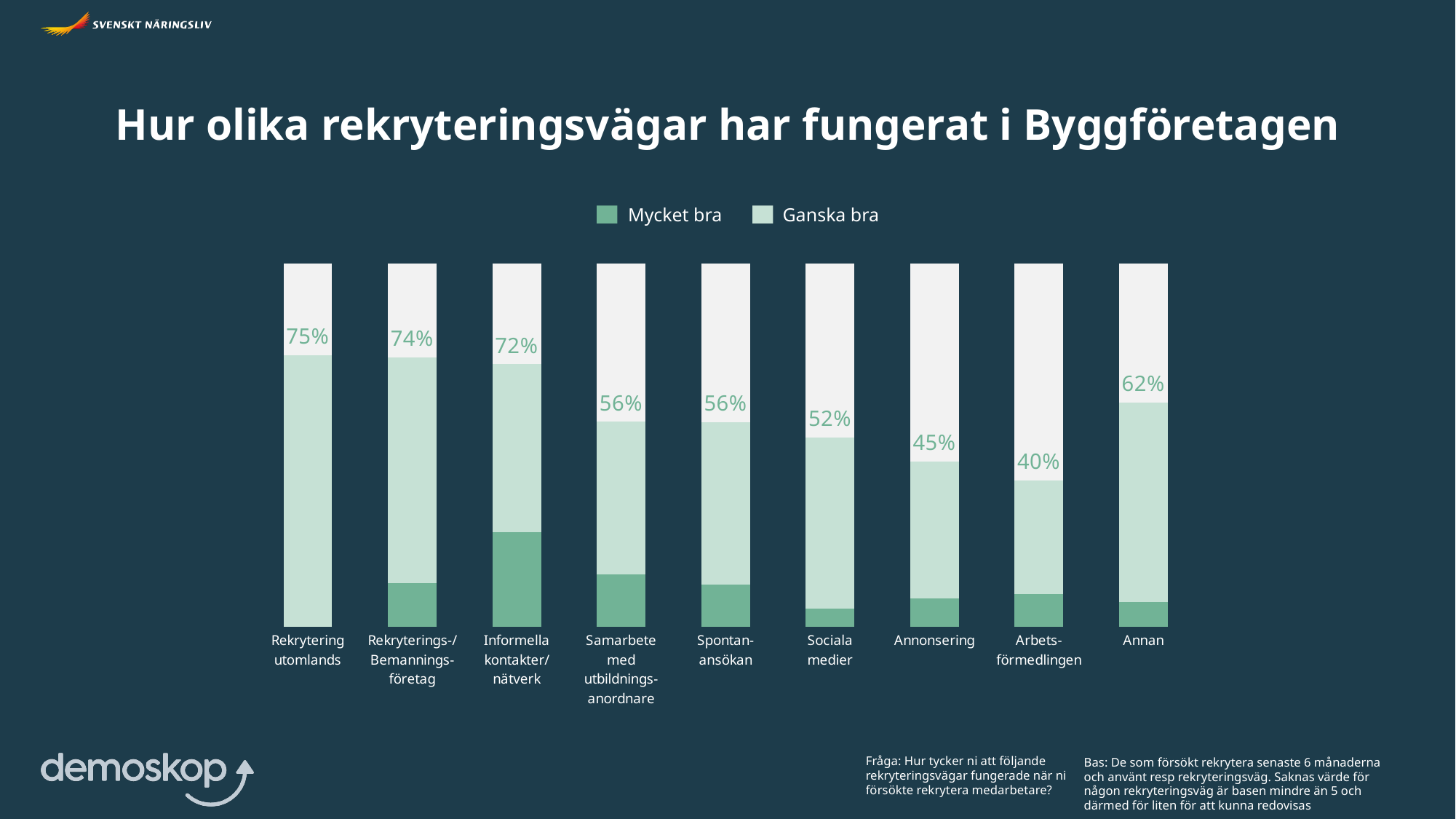
What is the total labelled value for Arbetsförmedlingen? 40% What is the difference between the labelled totals for Annonsering and Annan? 17 percentage points What is the total labelled value for Sociala medier? 52% What is the difference between the labelled totals for Rekrytering utomlands and Arbetsförmedlingen? 35 percentage points Which recruitment channel has the lowest labelled total? Arbetsförmedlingen What is the total labelled value for Annan? 62% Which has a larger labelled total, Sociala medier or Annan? Annan How many series does the legend list? 2 How many recruitment channels are shown on the x axis? 9 What is the total labelled value for Rekrytering utomlands? 75% What kind of chart is shown on the slide? Stacked bar chart Which recruitment channel has the highest labelled total? Rekrytering utomlands